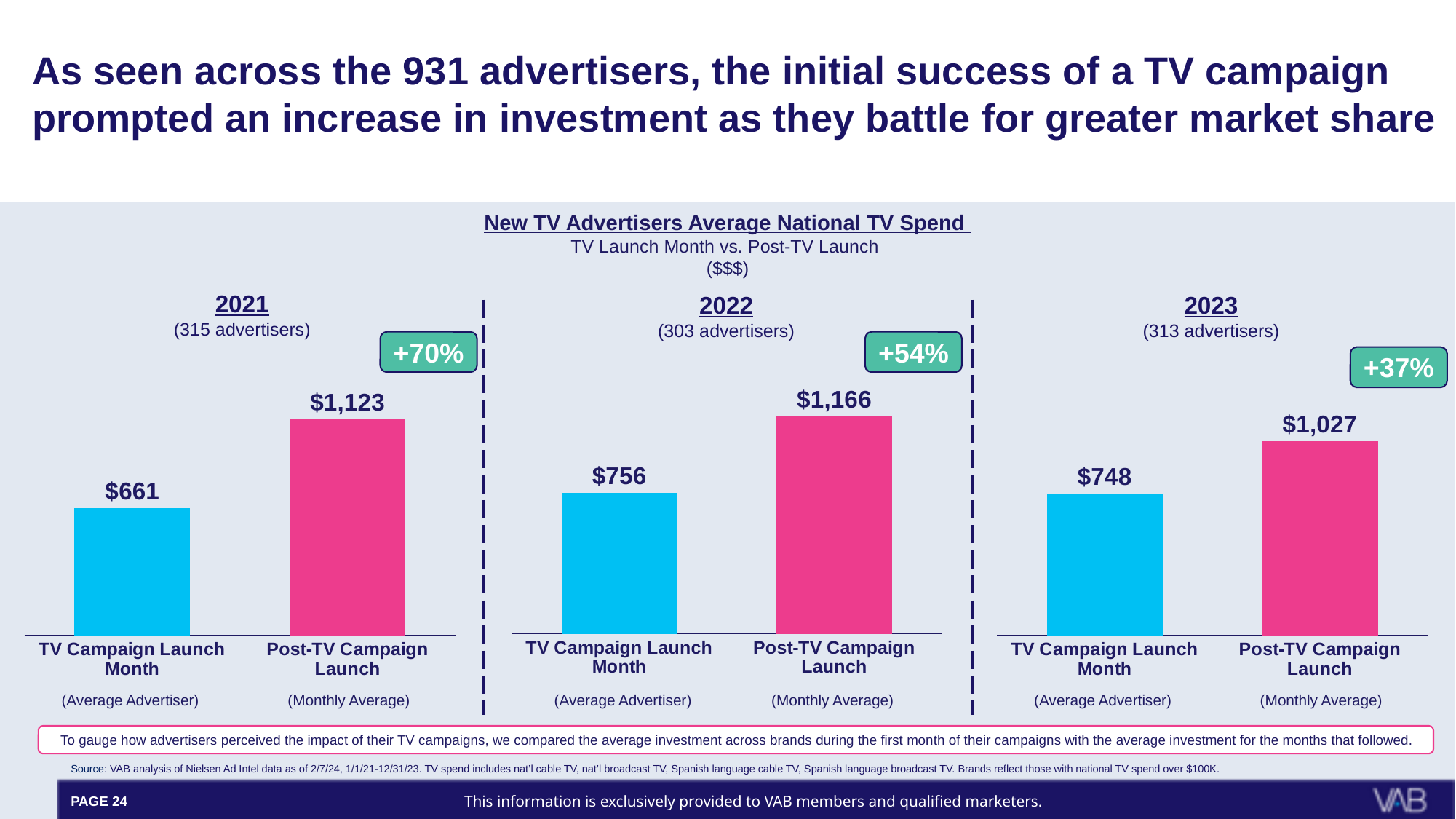
Across the three charts, which year has the lowest TV Campaign Launch Month value? 2021 In the 2021 chart, what is the value for Post-TV Campaign Launch? $1,123 What percentage increase is shown in the green box above the 2023 chart? +37% In the 2021 chart, what is the value for TV Campaign Launch Month? $661 Across the three charts, which year has the highest Post-TV Campaign Launch value? 2022 How many bars are shown in the 2023 chart? 2 In the 2022 chart, what is the value for TV Campaign Launch Month? $756 In the 2023 chart, what is the value for Post-TV Campaign Launch? $1,027 In the 2022 chart, what is the difference between Post-TV Campaign Launch and TV Campaign Launch Month? $410 In the 2023 chart, what is the difference between Post-TV Campaign Launch and TV Campaign Launch Month? $279 What type of chart is used for the 2022 data? Bar chart In the 2021 chart, which bar is higher, TV Campaign Launch Month or Post-TV Campaign Launch? Post-TV Campaign Launch